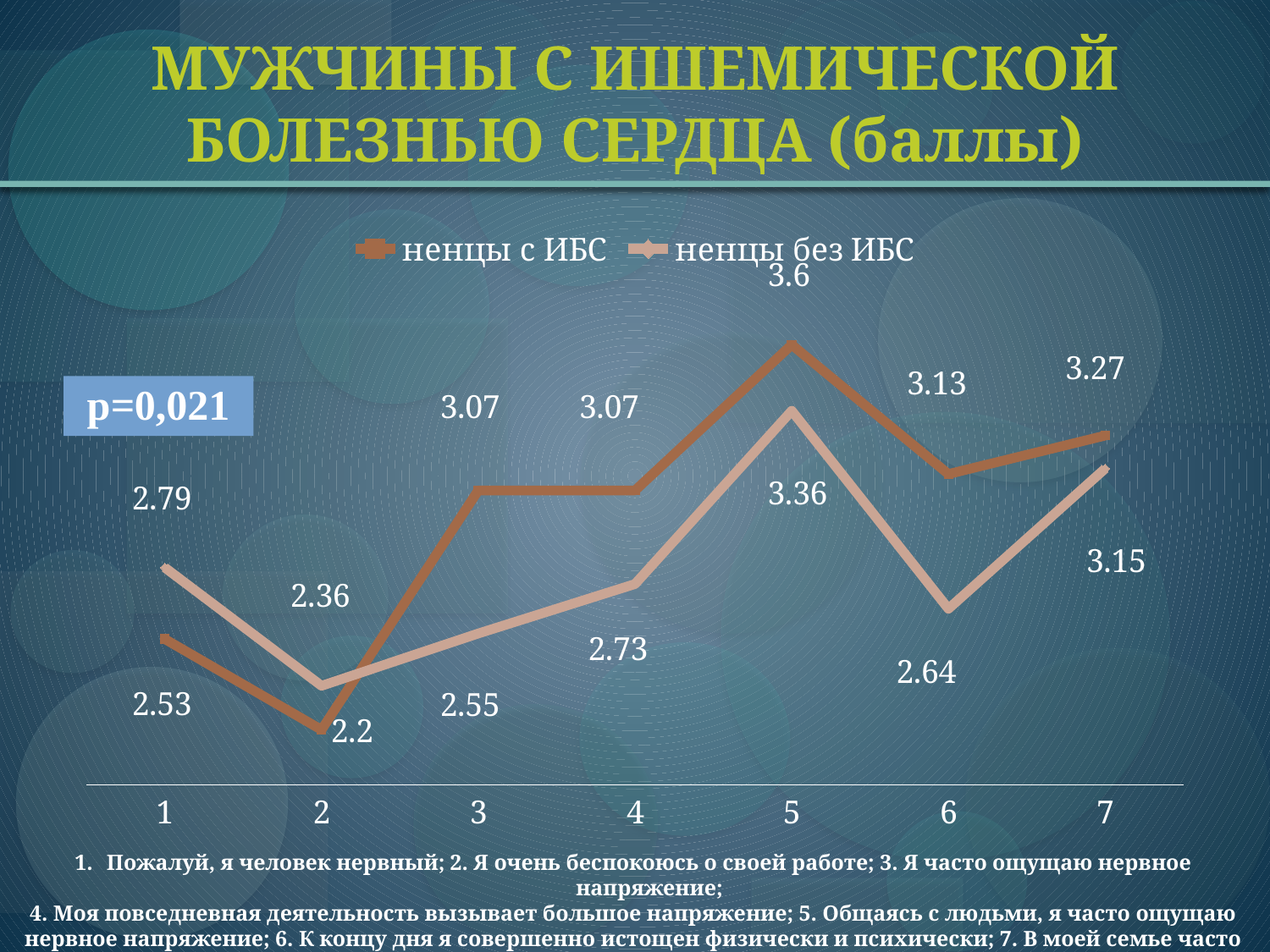
What is the value for category 2 in the series 'ненцы без ИБС'? 2.36 Does the series 'ненцы без ИБС' rise or fall from category 5 to category 6? fall Which category has the lowest value in the series 'ненцы без ИБС'? 2 What is the difference between the two series at category 6? 0.49 What type of chart is shown on the slide? line chart What is the value for category 5 in the series 'ненцы с ИБС'? 3.6 What p-value is shown on the slide? p=0,021 Which category has the highest value in the series 'ненцы с ИБС'? 5 How many series does the legend list? 2 How many categories are shown on the x axis? 7 What is the value for category 7 in the series 'ненцы с ИБС'? 3.27 At category 1, which series has the larger value? ненцы без ИБС